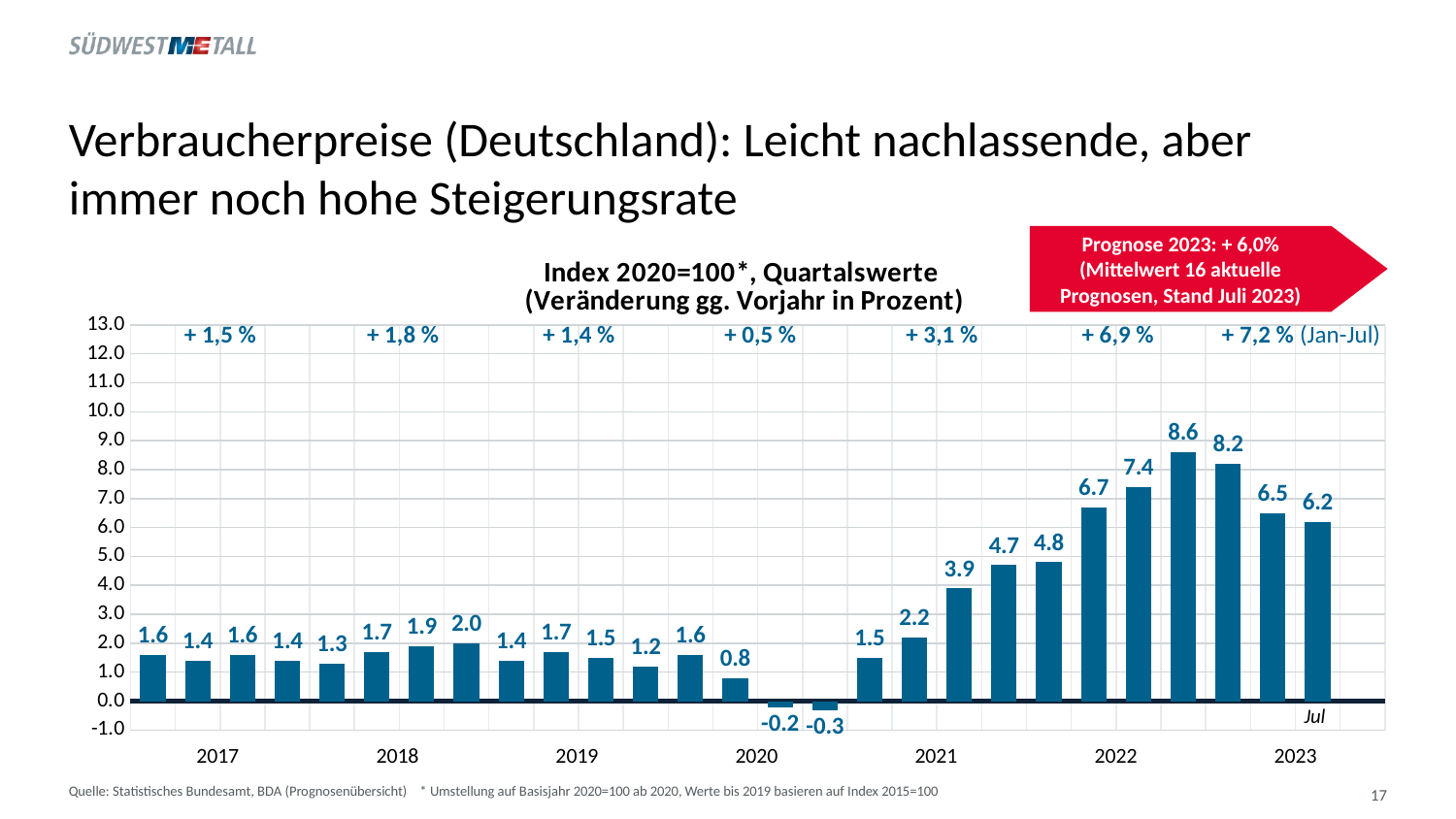
What is the value of the bar labelled "Jul" in 2023? 6.2 What forecast for 2023 is given in the red callout box? + 6,0% How many bars are plotted in the chart? 27 What kind of chart is shown on the slide? bar chart What annual change is shown for 2021 in the row of percentages at the top of the chart? + 3,1 % What is the highest quarterly value shown in the chart? 8.6 What is the lowest quarterly value shown in the chart? -0.3 Which is larger: the last bar of 2018 (2.0) or the first bar of 2019 (1.4)? 2.0 How many bars in the chart have negative values? 2 What annual change is shown for 2023 (Jan-Jul) at the top of the chart? + 7,2 % What is the difference between the highest bar (8.6) and the following bar (8.2)? 0.4